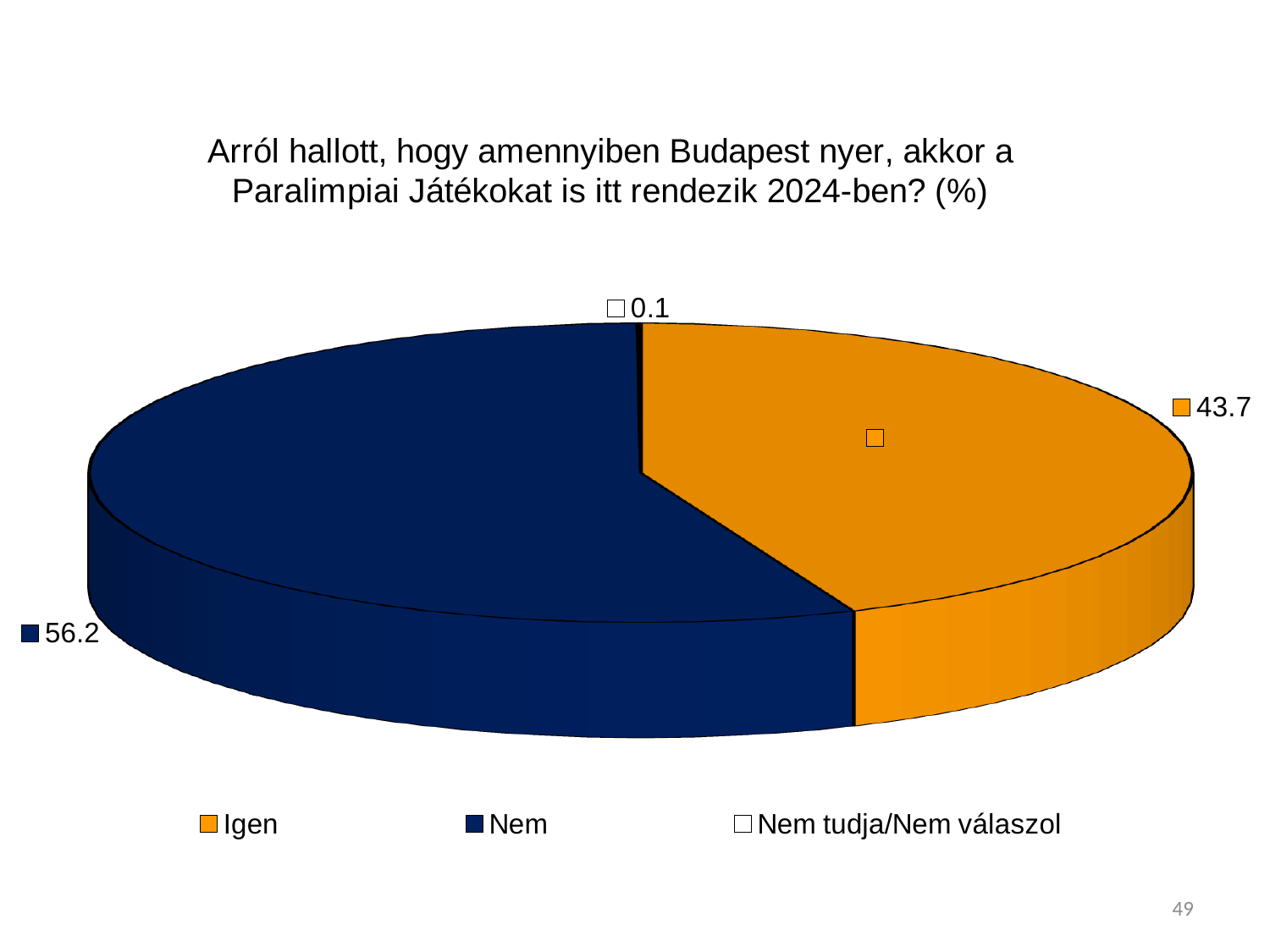
Which category has the smallest share of the pie? Nem tudja/Nem válaszol Which category has the largest share of the pie? Nem What colour is the slice for "Igen"? orange How many entries does the legend list? 3 What is the value for "Nem"? 56.2 What colour is the slice for "Nem"? dark blue What is the value for "Nem tudja/Nem válaszol"? 0.1 How many categories does the pie chart have? 3 What is the value for "Igen"? 43.7 What kind of chart is shown on the slide? pie chart What is the difference between the values for "Nem" and "Igen"? 12.5 Which is larger, the value for "Igen" or the value for "Nem"? Nem